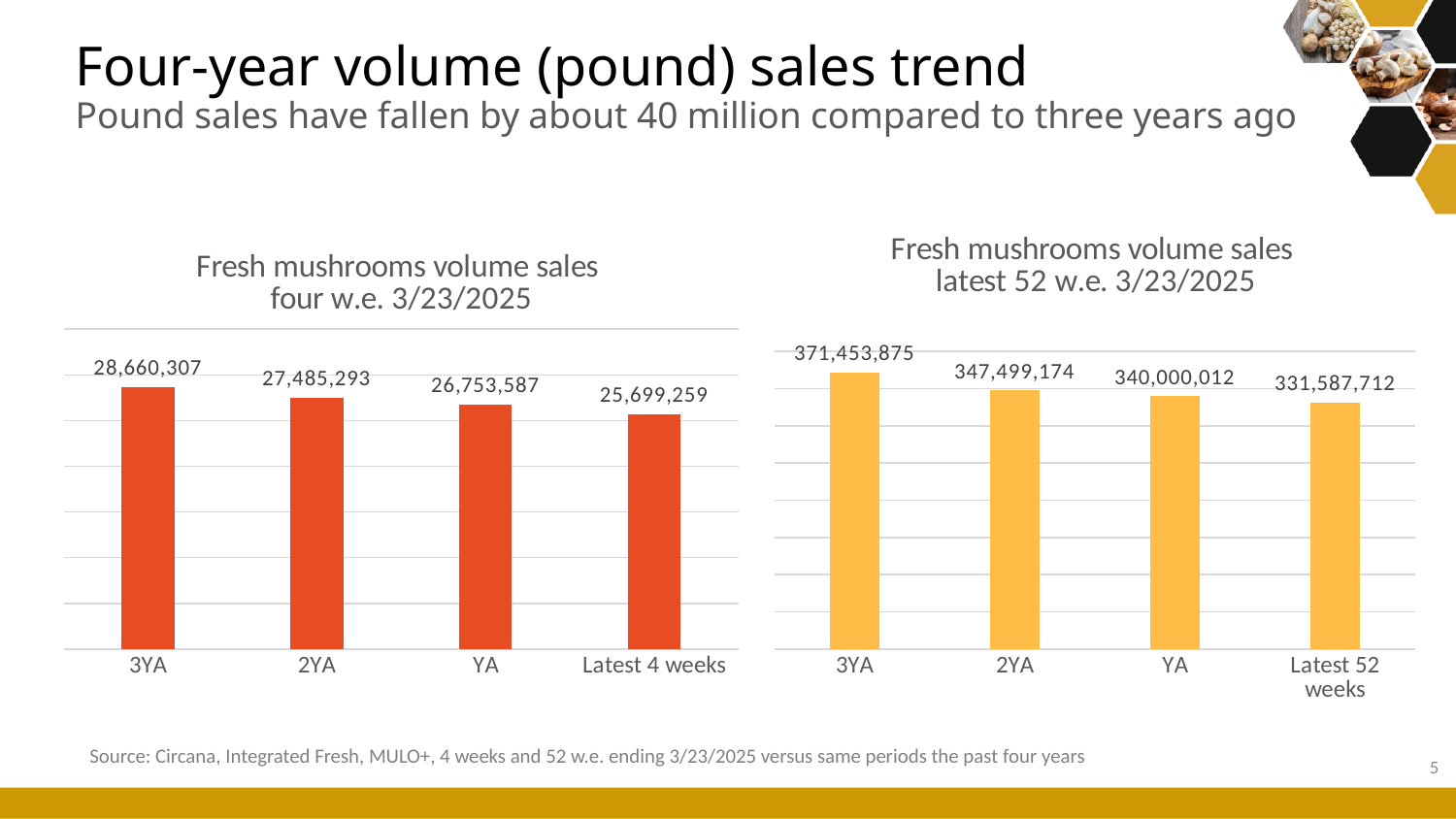
In the 'Fresh mushrooms volume sales latest 52 w.e. 3/23/2025' chart, which period has the highest value? 3YA What kind of chart is the 'Fresh mushrooms volume sales four w.e. 3/23/2025' chart? Bar chart In the 'Fresh mushrooms volume sales four w.e. 3/23/2025' chart, what is the value for Latest 4 weeks? 25,699,259 In the 'Fresh mushrooms volume sales four w.e. 3/23/2025' chart, which period has the lowest value? Latest 4 weeks In the 'Fresh mushrooms volume sales four w.e. 3/23/2025' chart, what is the difference between the 3YA value and the Latest 4 weeks value? 2,961,048 In the 'Fresh mushrooms volume sales latest 52 w.e. 3/23/2025' chart, do the values rise or fall from 3YA to Latest 52 weeks? Fall In the 'Fresh mushrooms volume sales four w.e. 3/23/2025' chart, what is the value for 3YA? 28,660,307 In the 'Fresh mushrooms volume sales latest 52 w.e. 3/23/2025' chart, what is the value for YA? 340,000,012 In the 'Fresh mushrooms volume sales four w.e. 3/23/2025' chart, which is larger, the value for 2YA or the value for YA? 2YA How many bars are in the 'Fresh mushrooms volume sales latest 52 w.e. 3/23/2025' chart? 4 In the 'Fresh mushrooms volume sales latest 52 w.e. 3/23/2025' chart, what is the value for 2YA? 347,499,174 In the 'Fresh mushrooms volume sales latest 52 w.e. 3/23/2025' chart, what is the difference between the 3YA value and the Latest 52 weeks value? 39,866,163